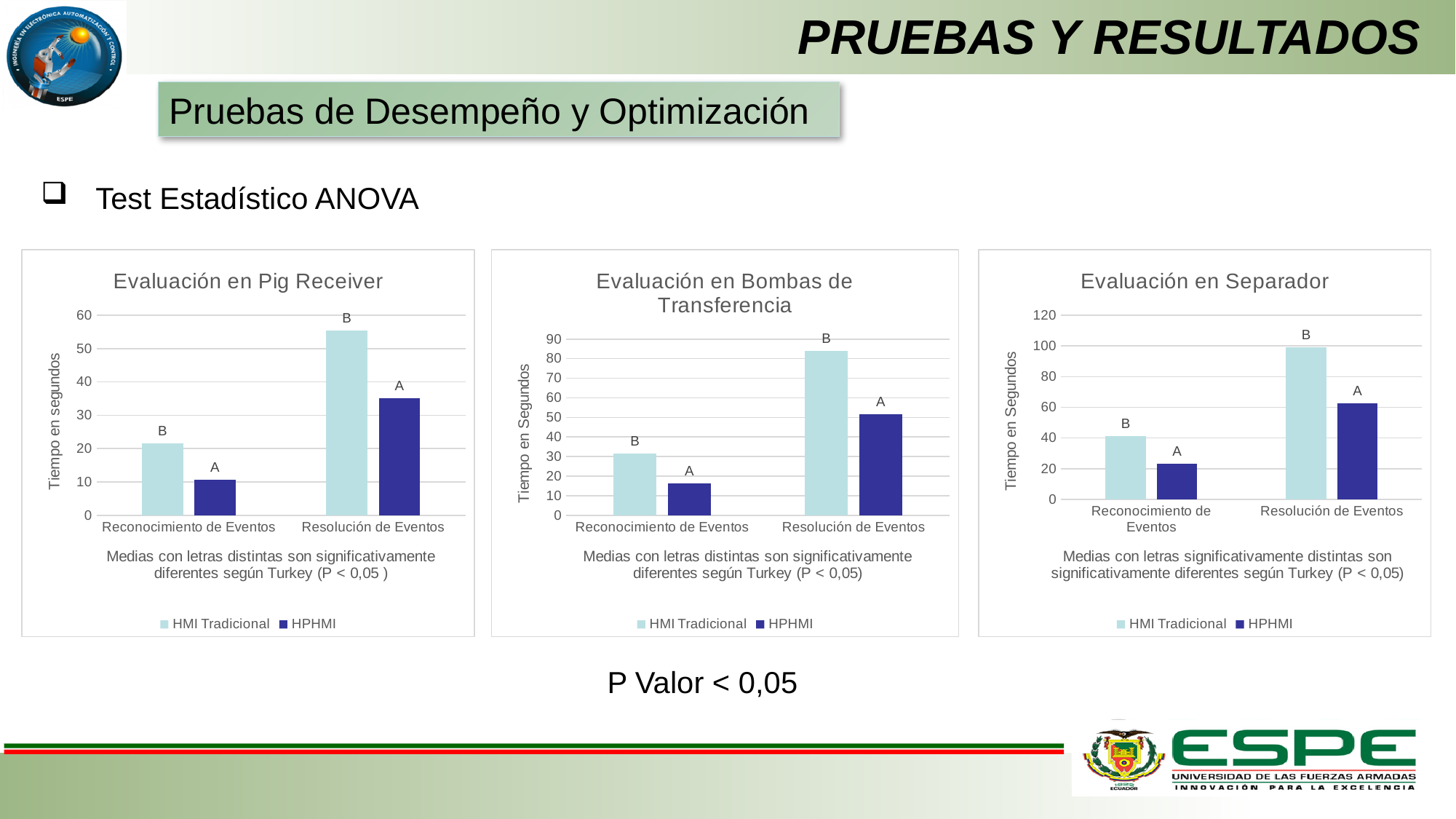
In the 'Evaluación en Pig Receiver' chart, is the HPHMI value for Reconocimiento de Eventos greater or less than 20? less In the 'Evaluación en Separador' chart, which bar is the lowest? HPHMI, Reconocimiento de Eventos In the 'Evaluación en Bombas de Transferencia' chart, is the HPHMI value for Reconocimiento de Eventos greater or less than 20? less In the 'Evaluación en Bombas de Transferencia' chart, is the HMI Tradicional value for Resolución de Eventos greater or less than 80? greater In the 'Evaluación en Pig Receiver' chart, how many series does the legend list? 2 In the 'Evaluación en Pig Receiver' chart, what kind of chart is shown? bar chart In the 'Evaluación en Separador' chart, what is the label of the y axis? Tiempo en Segundos In the 'Evaluación en Pig Receiver' chart, which series has the higher value for Resolución de Eventos, HMI Tradicional or HPHMI? HMI Tradicional In the 'Evaluación en Bombas de Transferencia' chart, which bar is the tallest? HMI Tradicional, Resolución de Eventos In the 'Evaluación en Bombas de Transferencia' chart, how many categories are shown on the x axis? 2